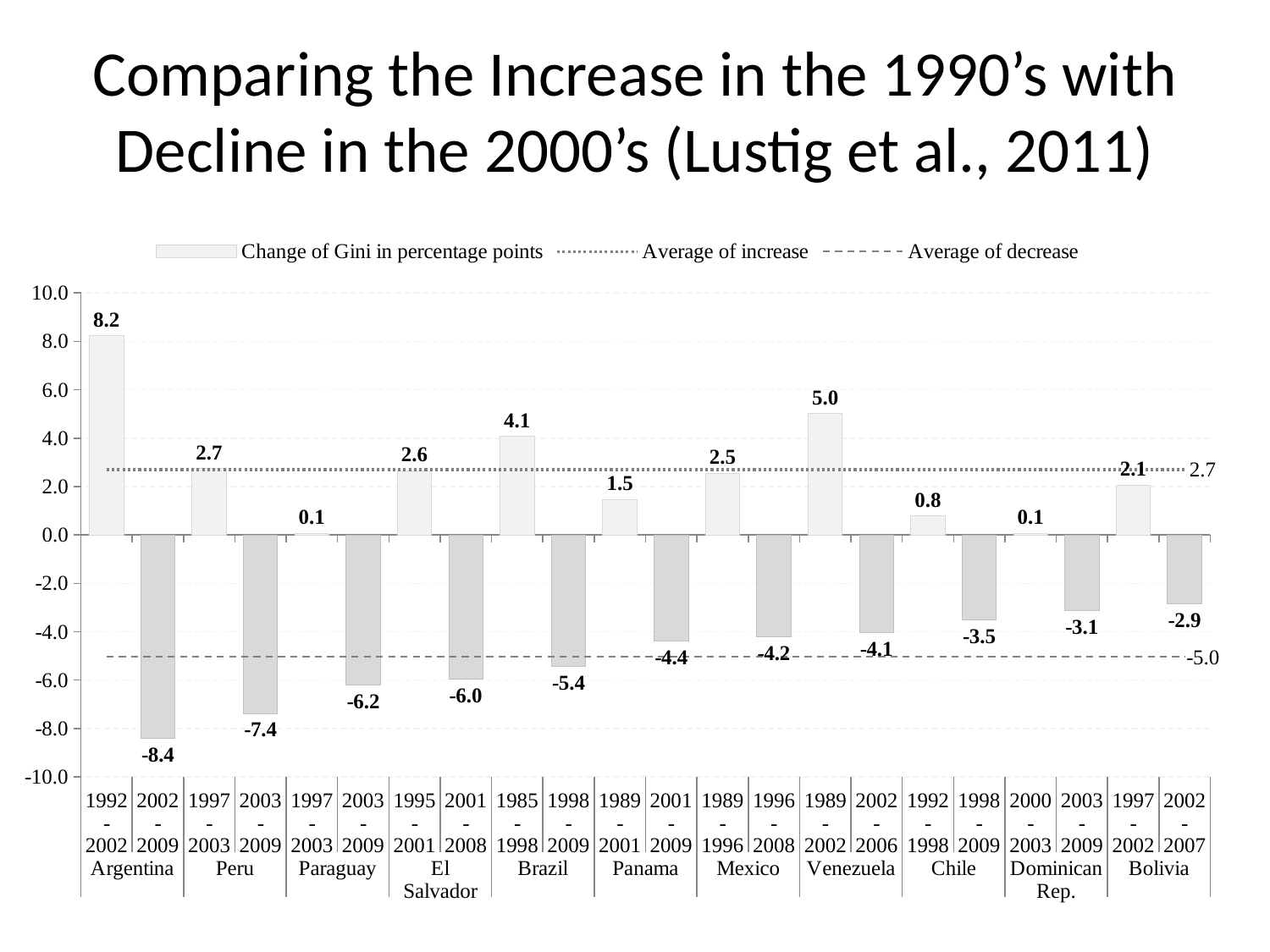
What is the change of Gini in percentage points for Argentina in 1992-2002? 8.2 Which country-period has the lowest change of Gini in percentage points? Argentina 2002-2009 What value does the Average of decrease line sit at? -5.0 How many countries are shown on the x axis? 11 What value does the Average of increase line sit at? 2.7 Which country-period has the highest change of Gini in percentage points? Argentina 1992-2002 What is the change of Gini in percentage points for Venezuela in 1989-2002? 5.0 What kind of chart is this? Combination bar and line chart Which is larger, the change of Gini for Mexico in 1989-1996 or for Bolivia in 1997-2002? Mexico 1989-1996 What is the difference between the change of Gini for Peru in 1997-2003 and Peru in 2003-2009? 10.1 How many series does the legend list? 3 What is the change of Gini in percentage points for Brazil in 1998-2009? -5.4